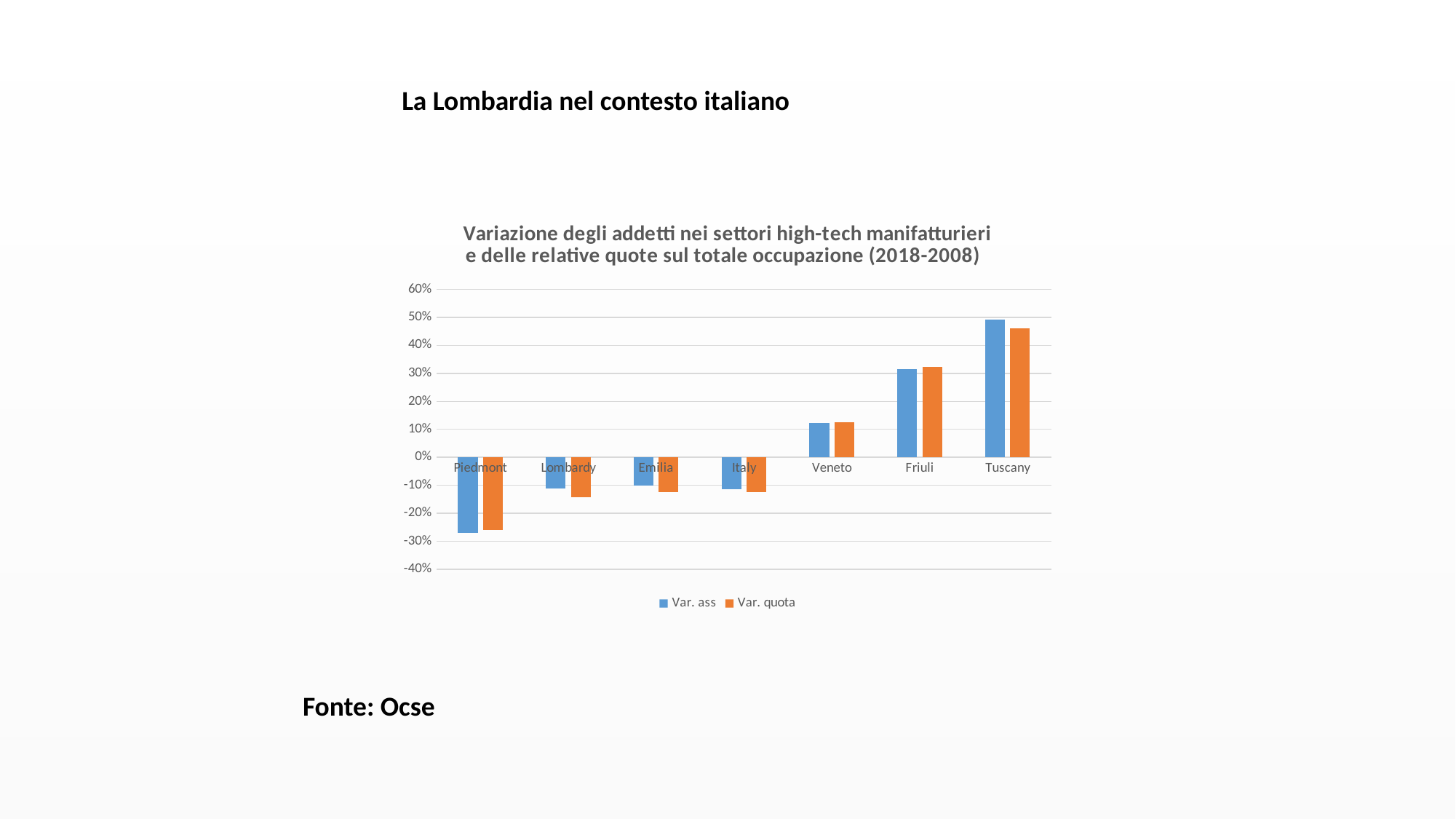
Is the Var. ass value for Tuscany greater or less than 40%? greater Is the Var. quota value for Veneto greater or less than 20%? less Is the Var. ass value for Piedmont greater or less than -20%? less What are the two series named in the legend? Var. ass and Var. quota What kind of chart is shown on the slide? bar chart How many regions/categories are shown on the x axis of the chart? 7 How many series does the chart's legend list? 2 Which category has the lowest Var. ass value? Piedmont Which has the larger Var. ass value, Tuscany or Friuli? Tuscany Do the Var. ass values generally rise or fall moving from Piedmont on the left to Tuscany on the right? rise Which category has the highest Var. ass value? Tuscany